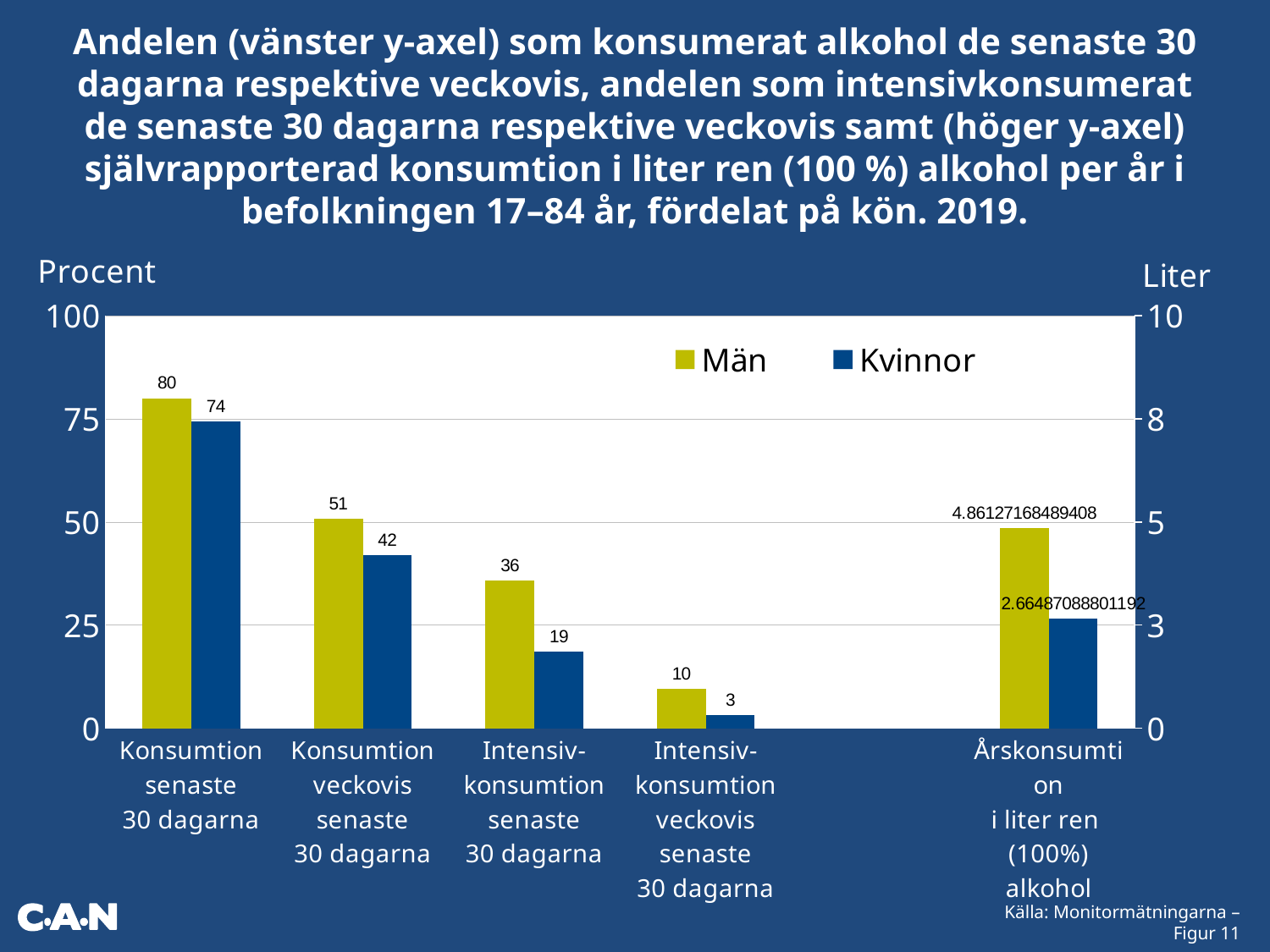
Which is larger in the category Konsumtion veckovis senaste 30 dagarna, Män or Kvinnor? Män What is the value for Kvinnor in the category Intensivkonsumtion senaste 30 dagarna? 19 What is the difference between Män and Kvinnor in the category Konsumtion senaste 30 dagarna? 6 Which category has the lowest value for Män? Intensivkonsumtion veckovis senaste 30 dagarna What is the difference between Män and Kvinnor in the category Intensivkonsumtion senaste 30 dagarna? 17 What is the value for Män in the category Intensivkonsumtion veckovis senaste 30 dagarna? 10 What kind of chart is shown on the slide? Bar chart Which category has the highest value for Kvinnor? Konsumtion senaste 30 dagarna What is the value for Män in the category Konsumtion senaste 30 dagarna? 80 How many series does the legend list? 2 What is the value for Kvinnor in the category Konsumtion veckovis senaste 30 dagarna? 42 What colour are the bars for Män? Yellow